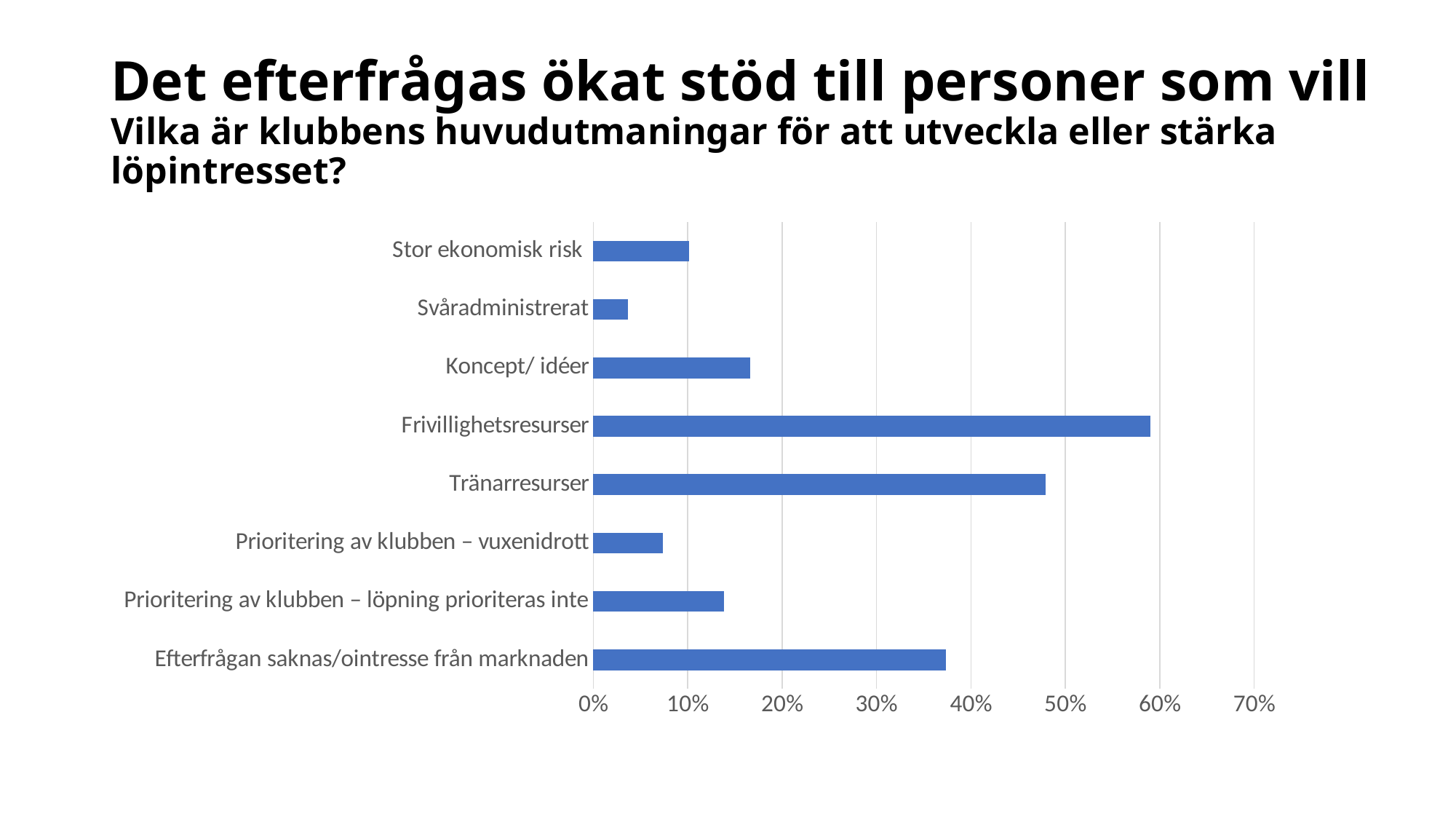
Which is larger, the value for Stor ekonomisk risk or the value for Prioritering av klubben – vuxenidrott? Stor ekonomisk risk Which category has the highest value? Frivillighetsresurser Is the value for Frivillighetsresurser greater or less than 50%? greater Which is larger, the value for Tränarresurser or the value for Efterfrågan saknas/ointresse från marknaden? Tränarresurser What kind of chart is shown on the slide? bar chart What is the highest value shown on the x axis of the chart? 70% Is the value for Koncept/ idéer greater or less than 20%? less Is the value for Tränarresurser greater or less than 40%? greater How many categories are shown in the chart? 8 Which category has the lowest value? Svåradministrerat